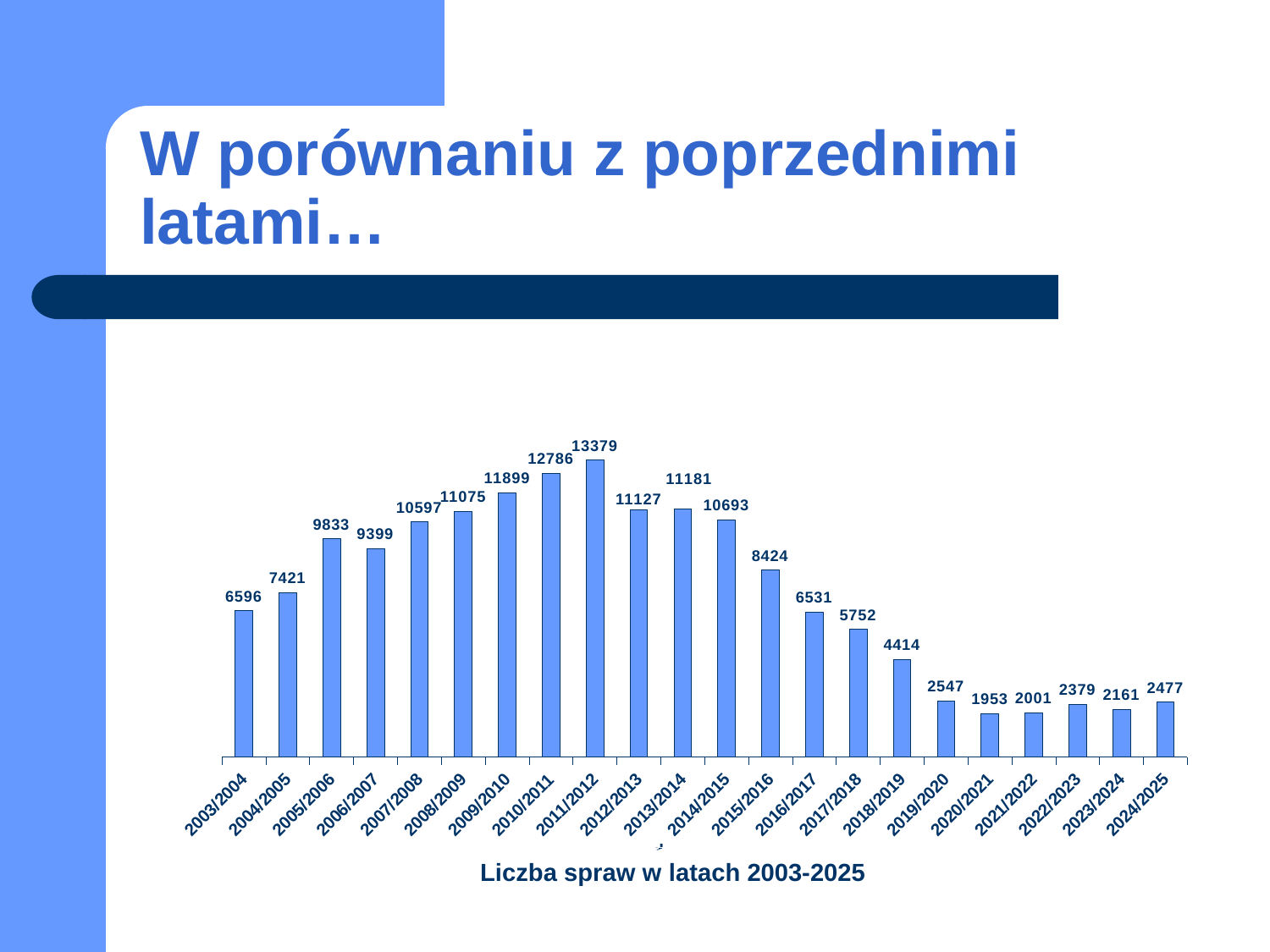
What is the value for 2003/2004? 6596 Which year has the lowest value? 2020/2021 Which year has the highest value? 2011/2012 What is the difference between the values for 2011/2012 and 2020/2021? 11426 What is the value for 2011/2012? 13379 What is the value for 2024/2025? 2477 What kind of chart is this? bar chart Which is larger, the value for 2013/2014 or the value for 2012/2013? 2013/2014 What is the title of the chart? Liczba spraw w latach 2003-2025 How many years are shown on the x axis? 22 What is the difference between the values for 2024/2025 and 2023/2024? 316 What is the value for 2018/2019? 4414